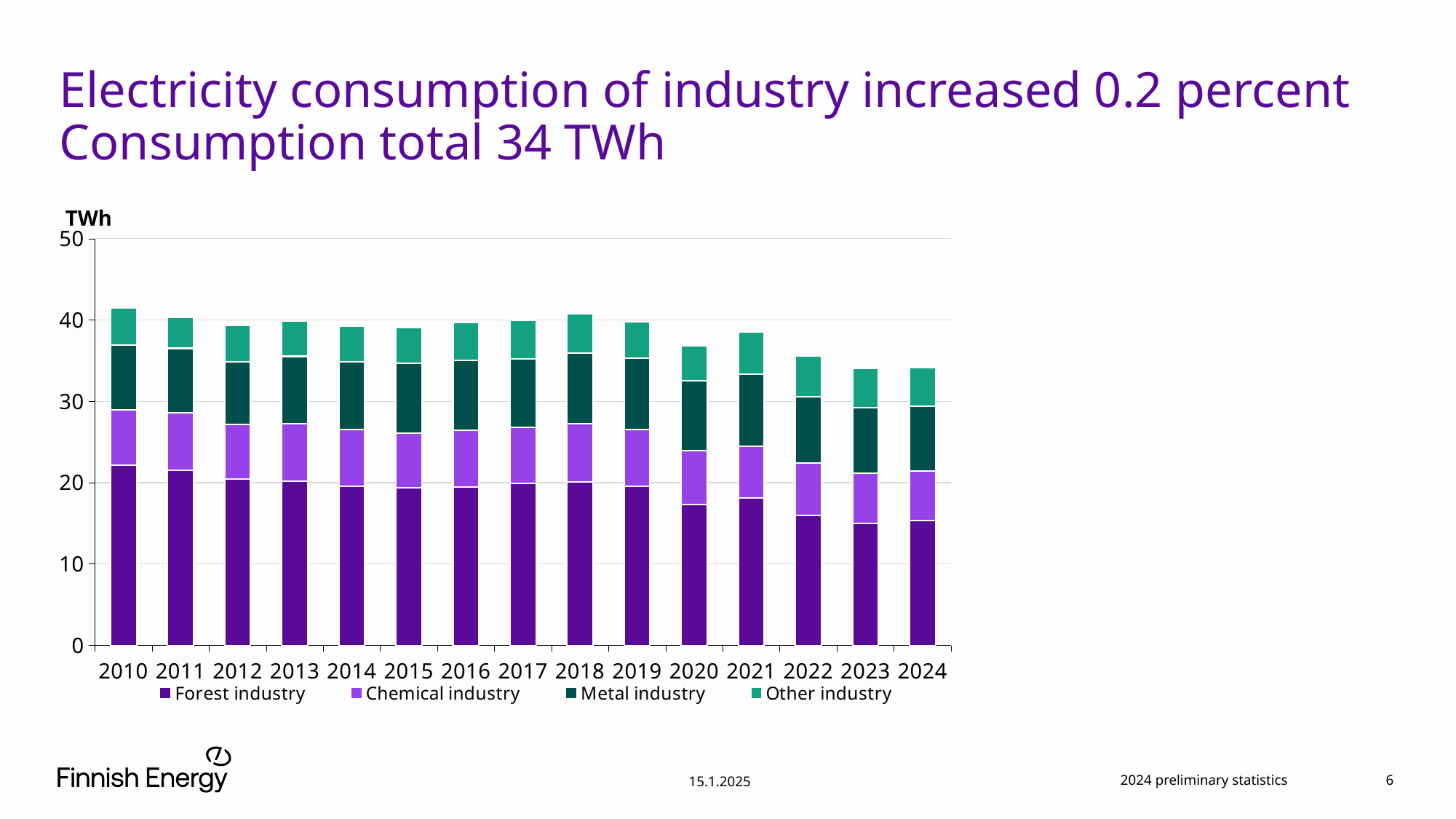
Do the total stacked bars generally rise or fall from 2010 to 2024? fall How many series does the chart's legend list? 4 Which year has the tallest total stacked bar? 2010 What kind of chart is shown on the slide? Stacked bar chart Is the total stacked bar for 2024 greater or less than 40? less Is the total stacked bar for 2010 greater or less than 40? greater Is the Forest industry value for 2010 greater or less than 20? greater What unit is shown on the vertical axis of the chart? TWh Which is larger, the total bar for 2010 or the total bar for 2024? 2010 Which industries are listed in the chart's legend? Forest industry, Chemical industry, Metal industry, Other industry How many years are shown on the x axis of the chart? 15